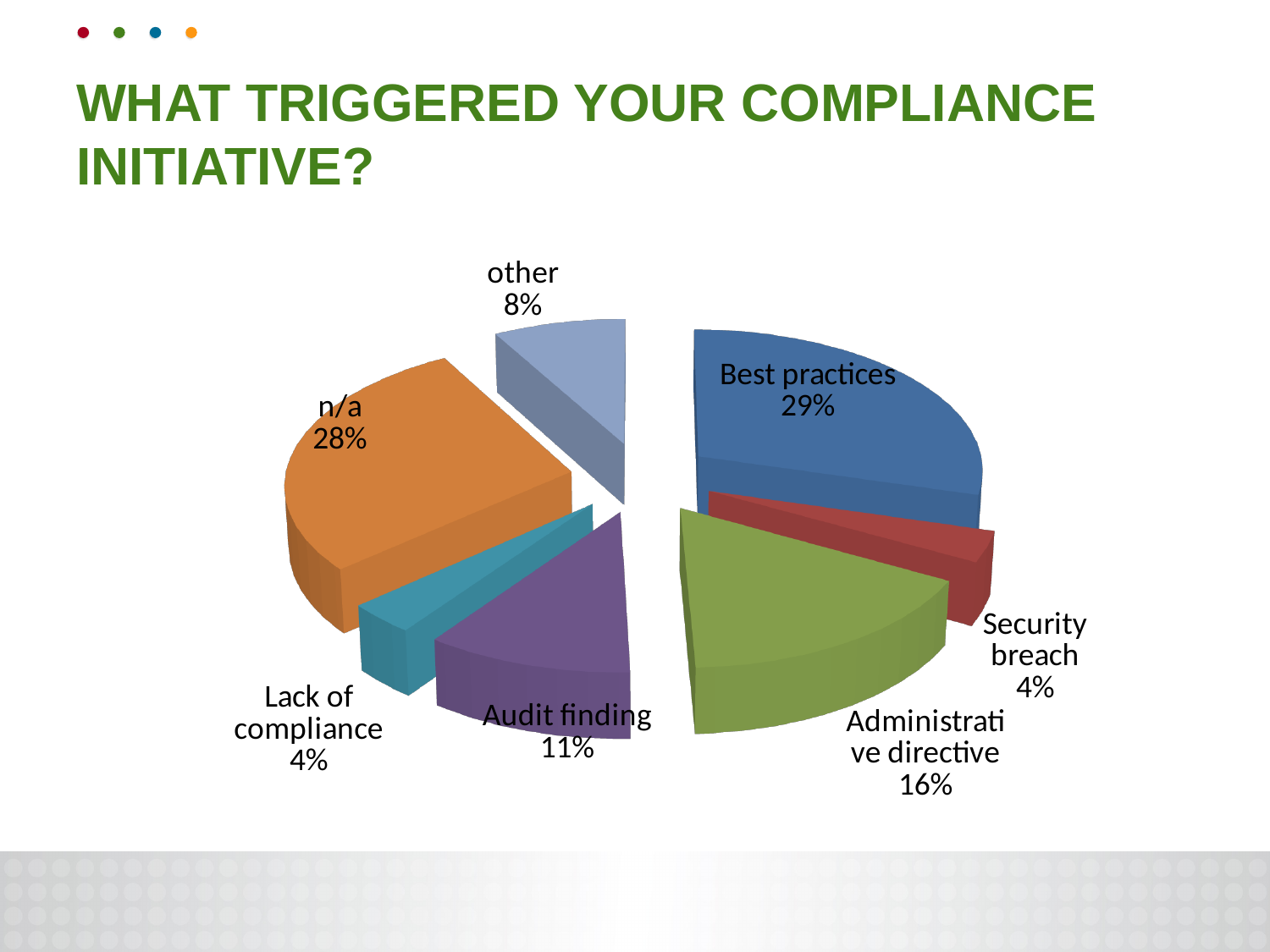
How many slices does the pie chart have? 7 What is the difference in percentage points between Best practices and Administrative directive? 13 What percentage is shown for Audit finding? 11% Which is larger, the share for Audit finding or the share for other? Audit finding What share of the pie is labelled Best practices? 29% What is the combined share of Security breach and Lack of compliance? 8% What percentage is shown for Administrative directive? 16% What percentage is shown for n/a? 28% What percentage is shown for the 'other' slice? 8% What is the title of the slide containing the pie chart? WHAT TRIGGERED YOUR COMPLIANCE INITIATIVE? What kind of chart is shown on the slide? pie chart Which category has the largest share of the pie? Best practices